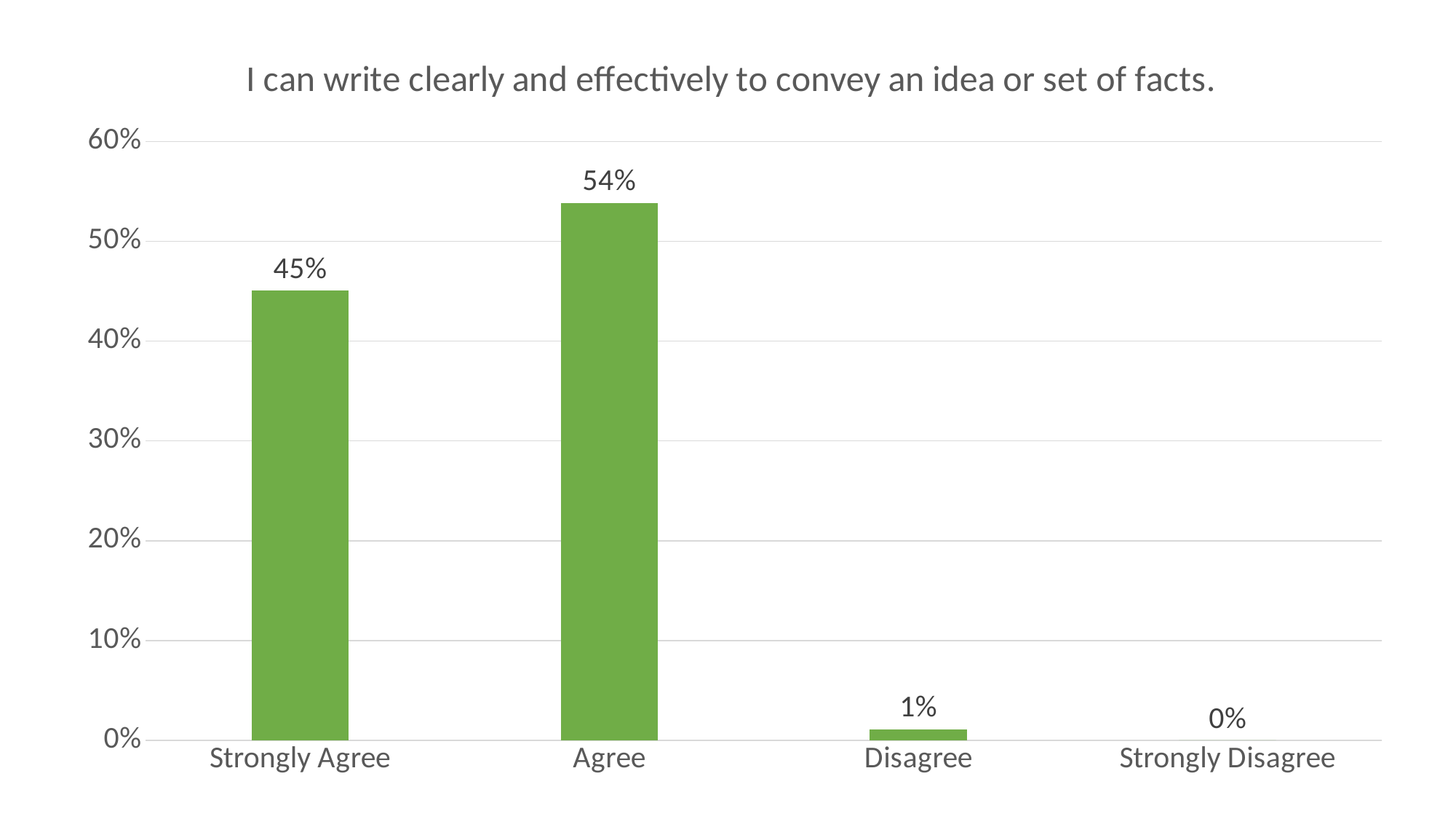
What is the value for Disagree? 1% How many categories are shown on the x axis? 4 What is the value for Strongly Agree? 45% Which category has the lowest value? Strongly Disagree What is the value for Agree? 54% What is the value for Strongly Disagree? 0% Which category has the highest value? Agree What is the difference between the values for Agree and Strongly Agree? 9% What kind of chart is shown on the slide? bar chart What is the title of the chart? I can write clearly and effectively to convey an idea or set of facts. Is the value for Agree greater or less than 50%? greater Which is larger, the value for Strongly Agree or the value for Disagree? Strongly Agree